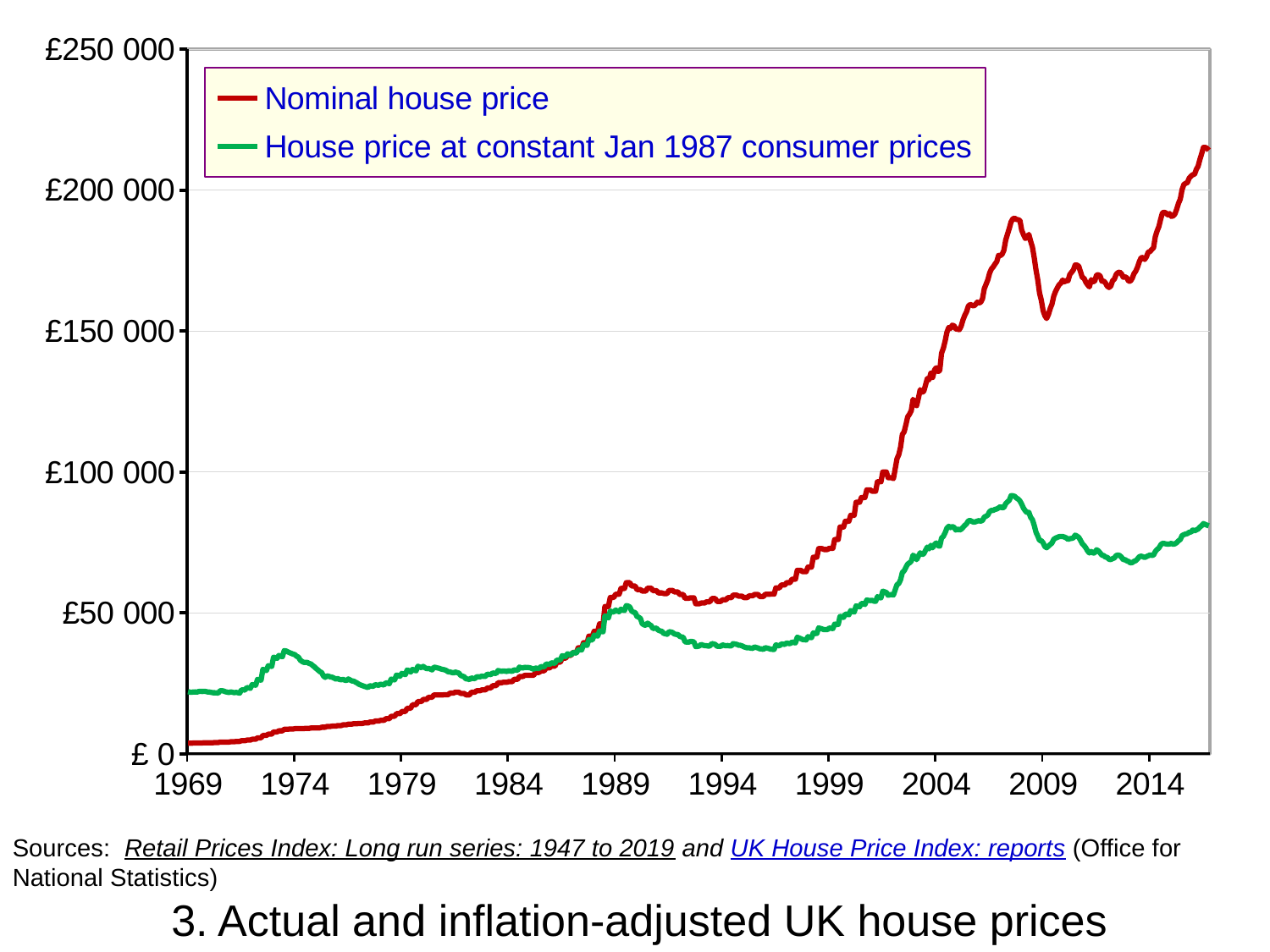
Is the House price at constant Jan 1987 consumer prices in 2009 greater or less than £100 000? less How many year labels are shown on the x axis? 10 What kind of chart is shown on the slide? Line chart Is the Nominal house price in 1999 greater or less than £100 000? less What is the title of the chart? 3. Actual and inflation-adjusted UK house prices How many series does the legend list? 2 Is the Nominal house price in 2014 greater or less than £150 000? greater Does the Nominal house price generally rise or fall between 1994 and 2004? rise Which series is drawn in red? Nominal house price In 2014, which series has the higher value: Nominal house price or House price at constant Jan 1987 consumer prices? Nominal house price In 1969, which series has the higher value: Nominal house price or House price at constant Jan 1987 consumer prices? House price at constant Jan 1987 consumer prices